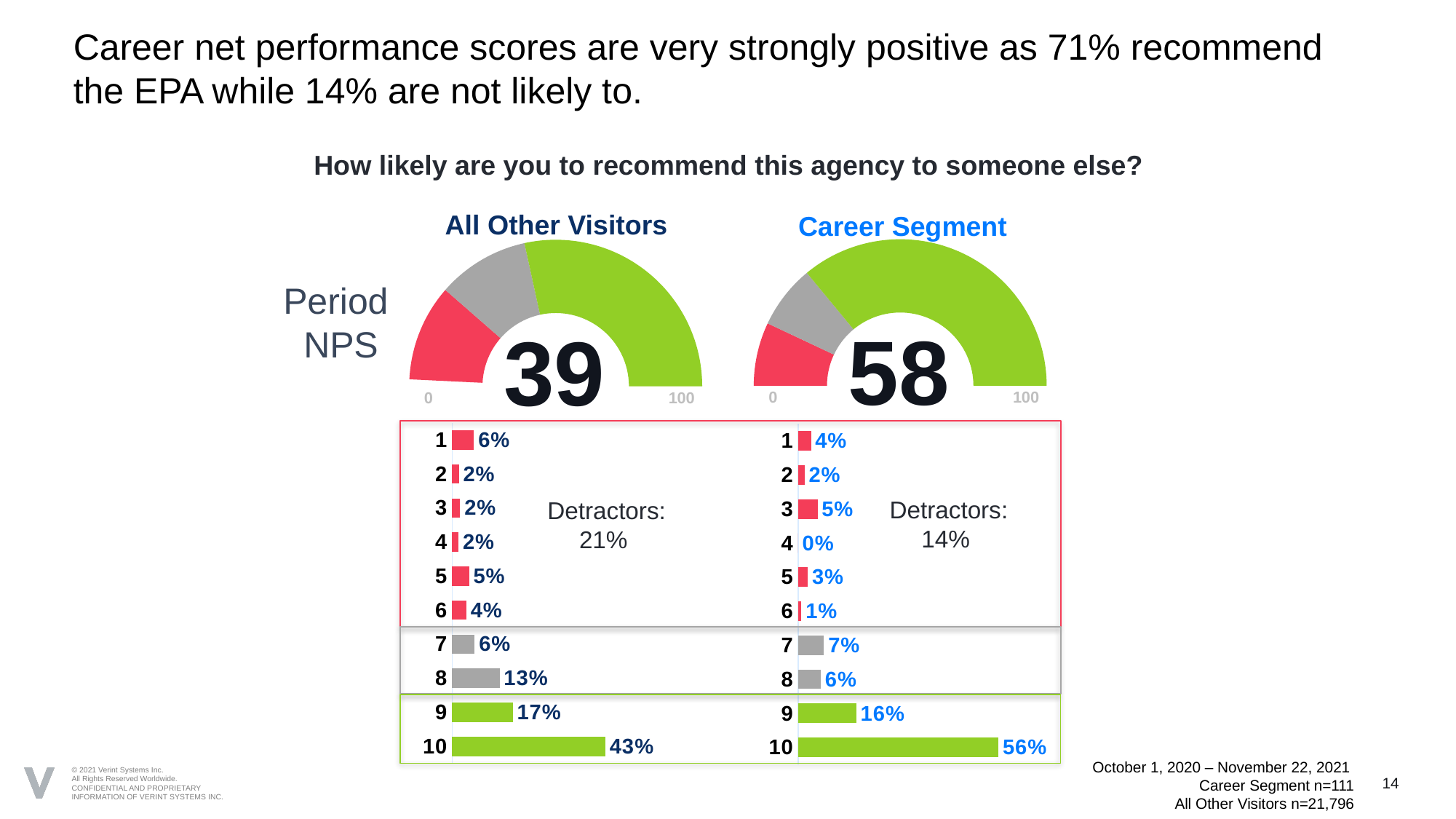
On the All Other Visitors gauge, what is the Period NPS value shown? 39 In the Career Segment bar chart, which rating has the lowest percentage? 4 What is the difference between the Career Segment and All Other Visitors percentages for a rating of 10? 13 percentage points On the Career Segment gauge, what is the Period NPS value shown? 58 How many rating categories are shown in the All Other Visitors bar chart? 10 What kind of chart is used to show the distribution of ratings 1 to 10 for each group? Bar chart In the Career Segment bar chart, which rating has the highest percentage? 10 In the Career Segment bar chart, what percentage gave a rating of 10? 56% What is the Detractors percentage shown for the Career Segment? 14% In the All Other Visitors bar chart, what is the combined percentage for ratings 7 and 8? 19% For a rating of 9, which group has the larger percentage, All Other Visitors or Career Segment? All Other Visitors In the All Other Visitors bar chart, what percentage gave a rating of 8? 13%